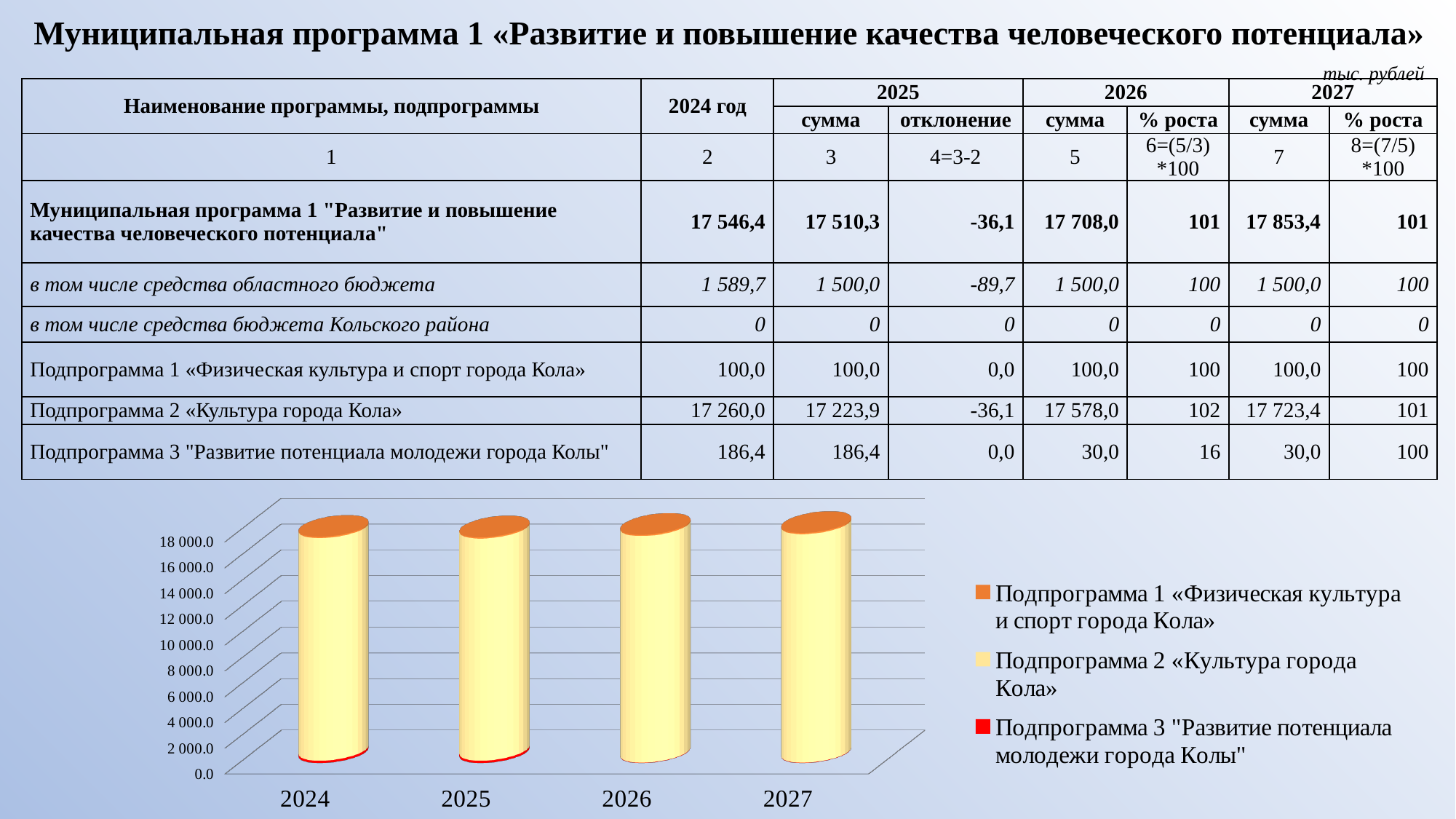
Which is larger: the value for Подпрограмма 2 «Культура города Кола» in 2024 or in 2027? 2027 Is the value for Подпрограмма 1 «Физическая культура и спорт города Кола» in 2027 greater or less than 2 000.0? less What is the value for Подпрограмма 2 «Культура города Кола» in 2026, as printed in the table? 17 578,0 Is the total height of the stacked bar for 2024 greater or less than 16 000.0? greater What is the total of the stacked bar for 2024 (the whole municipal programme), as printed in the table? 17 546,4 What kind of chart is shown at the bottom of the slide? bar chart Which year has the largest total for the municipal programme according to the table? 2027 How many years (categories) are shown on the x axis of the chart? 4 Which series in the chart legend is shown in yellow? Подпрограмма 2 «Культура города Кола» What is the value for Подпрограмма 3 "Развитие потенциала молодежи города Колы" in 2024, as printed in the table? 186,4 How many series does the chart legend list? 3 Which series in the chart legend is shown in red? Подпрограмма 3 "Развитие потенциала молодежи города Колы"